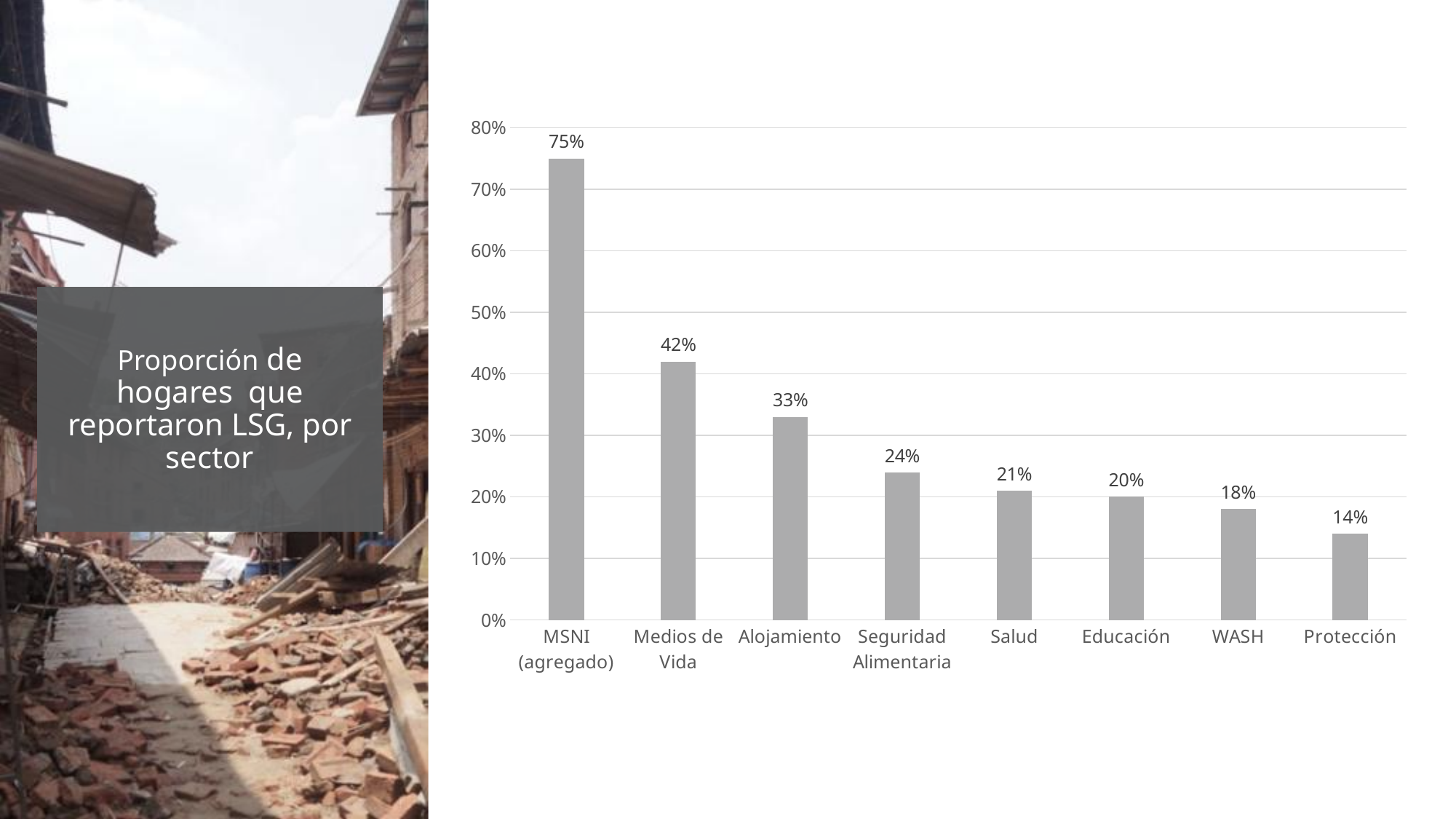
What is the difference between the values for Alojamiento and WASH? 15% What kind of chart is shown on the slide? bar chart What is the difference between the values for MSNI (agregado) and Medios de Vida? 33% Which category has the lowest value? Protección Which category has the highest value? MSNI (agregado) How many categories are shown on the x axis? 8 Which is larger, the value for Seguridad Alimentaria or the value for Educación? Seguridad Alimentaria Do the values rise or fall from left to right along the x axis? fall What is the value for Salud? 21% What is the value for Medios de Vida? 42% Is the value for Alojamiento greater or less than 30%? greater What is the value for Protección? 14%